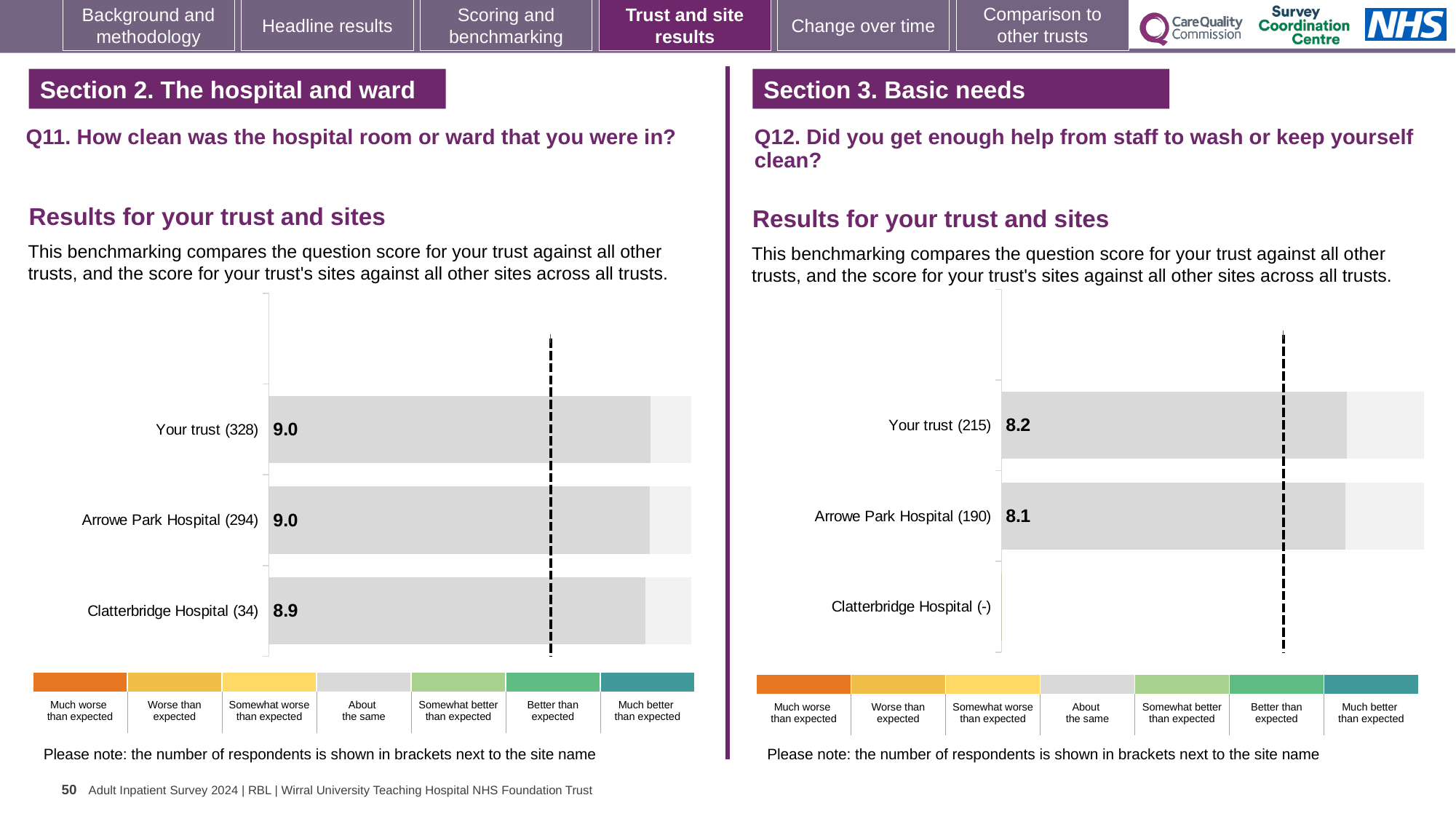
In the Q11 chart on the left, what is the difference between the score for Your trust and the score for Clatterbridge Hospital? 0.1 In the Q11 chart on the left, what is the score for Clatterbridge Hospital? 8.9 In the Q11 chart on the left, which site has the lowest score? Clatterbridge Hospital In the Q12 chart on the right, which is larger, the score for Your trust or the score for Arrowe Park Hospital? Your trust In the Q11 chart on the left, what is the score for Your trust? 9.0 In the Q12 chart on the right, how many respondents are shown in brackets for Your trust? 215 What kind of chart is the Q11 chart on the left? Bar chart In the Q12 chart on the right, what is the score for Your trust? 8.2 In the Q11 chart on the left, what is the score for Arrowe Park Hospital? 9.0 In the Q12 chart on the right, what is the score for Arrowe Park Hospital? 8.1 In the Q11 chart on the left, how many respondents are shown in brackets for Arrowe Park Hospital? 294 How many categories (rows) are shown in the Q12 chart on the right? 3